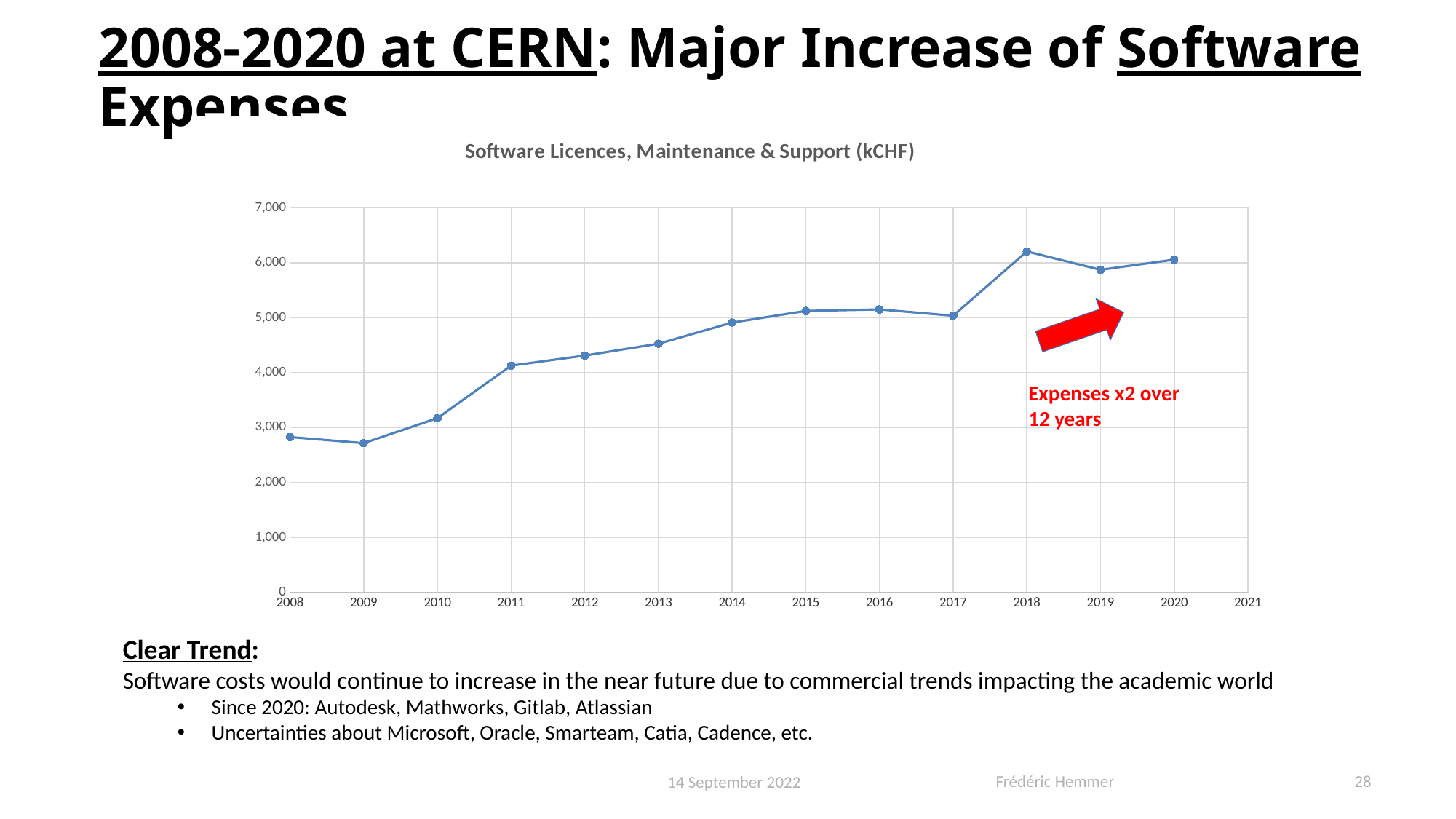
In which year is the value lowest? 2009 Do the values generally rise or fall from 2008 to 2020? rise How many data points are plotted on the line? 13 Is the value for 2011 greater or less than 4,000? greater Is the value for 2014 greater or less than 5,000? less What is the title of the chart? Software Licences, Maintenance & Support (kCHF) In which year is the value highest? 2018 What kind of chart is shown on the slide? line chart Is the value for 2008 greater or less than 3,000? less Which year has the larger value, 2018 or 2019? 2018